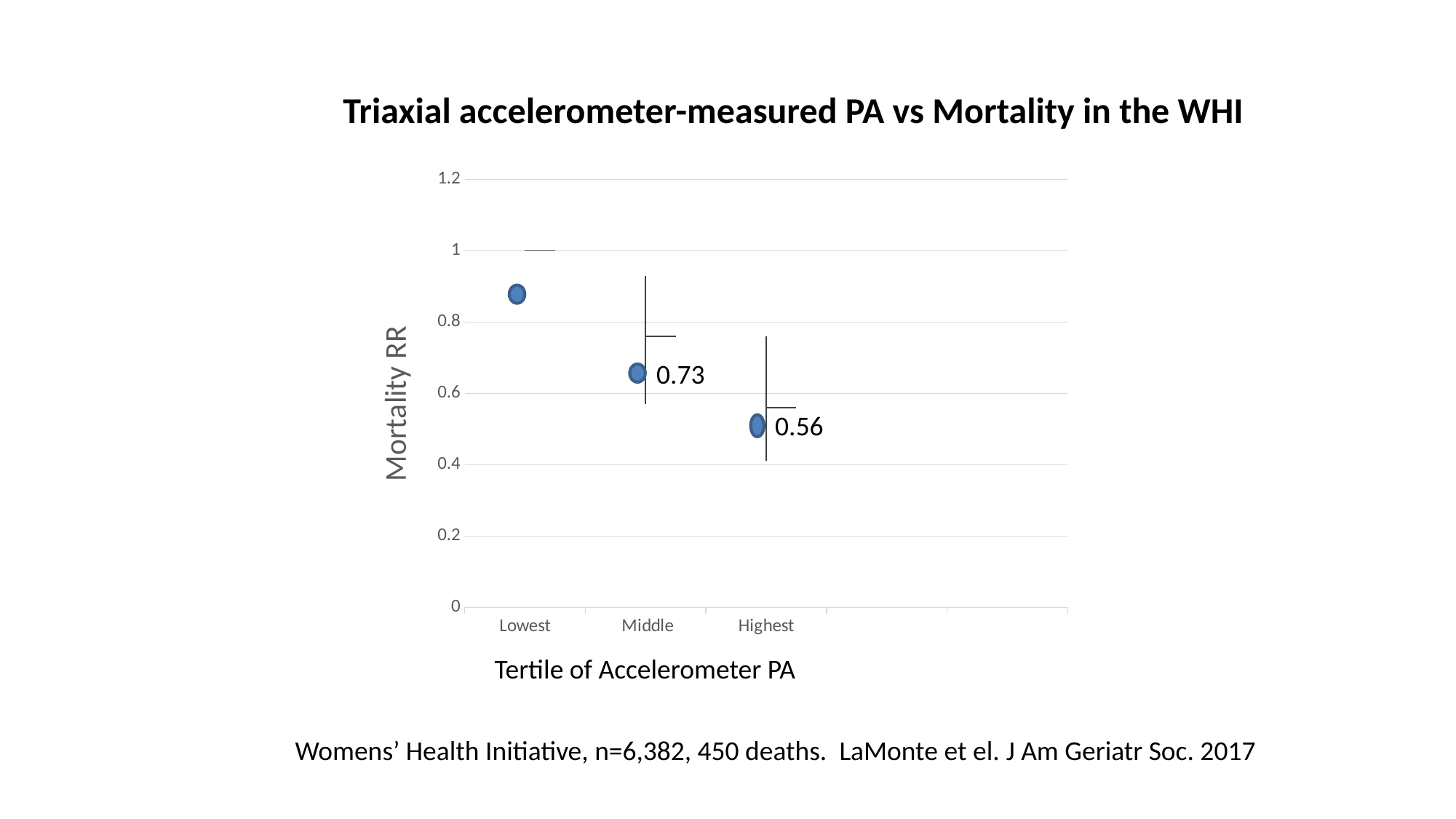
Which tertile of accelerometer PA has the lowest mortality RR? Highest Which tertile of accelerometer PA has the highest mortality RR? Lowest What is the difference between the labelled mortality RR values for the Middle and Highest tertiles? 0.17 What is the title of the y axis? Mortality RR What is the mortality RR value labelled for the Highest tertile? 0.56 What is the mortality RR value labelled for the Middle tertile? 0.73 Is the mortality RR for the Lowest tertile greater or less than 0.8? greater What kind of chart is shown on the slide? Scatter (dot) plot Does mortality RR rise or fall as the tertile of accelerometer PA increases from Lowest to Highest? Fall How many tertile categories are plotted on the x axis? 3 Which has the larger mortality RR, the Middle tertile or the Highest tertile? Middle What is the title of the x axis? Tertile of Accelerometer PA